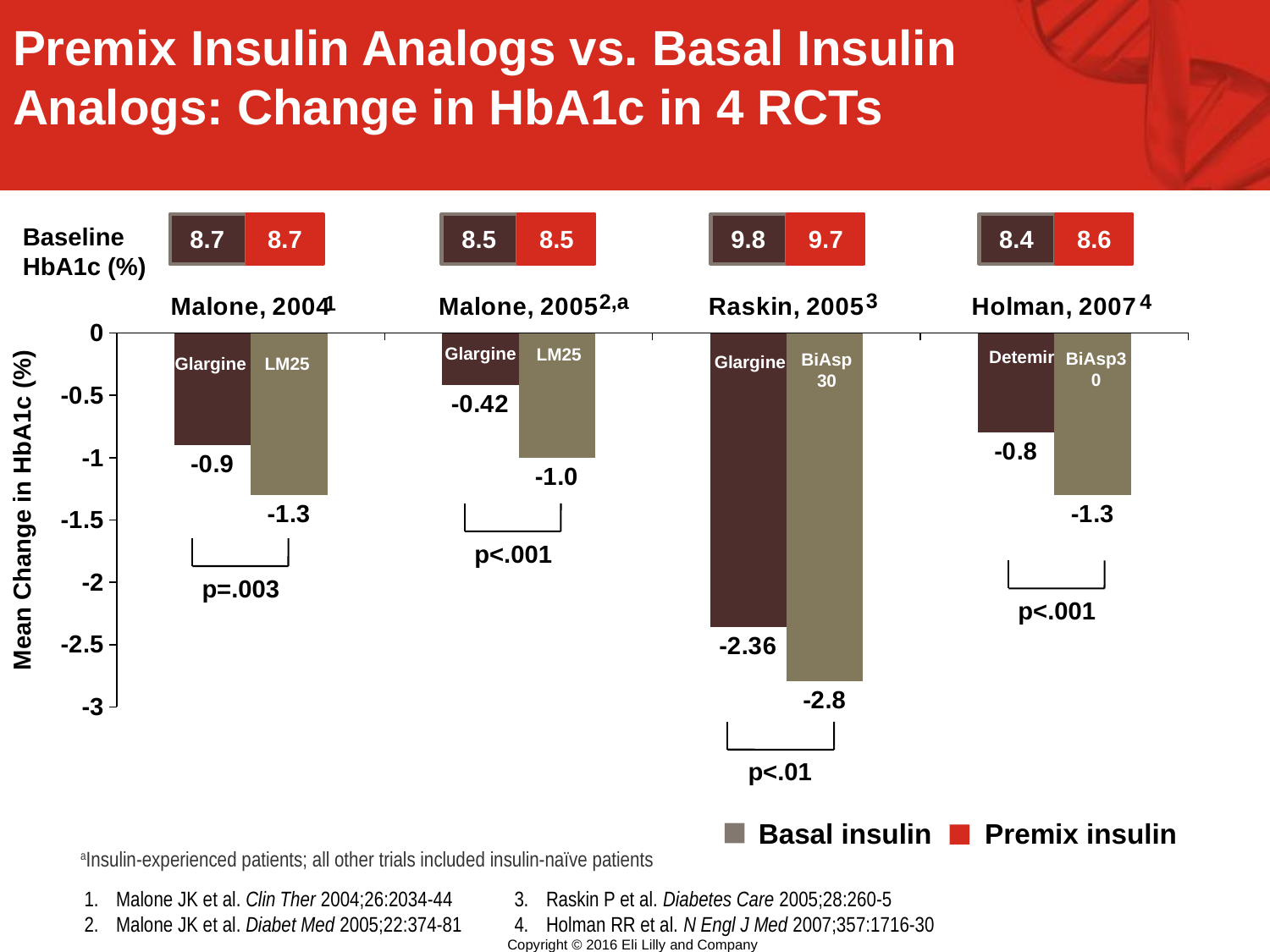
What type of chart is used to show the mean change in HbA1c? Bar chart How many studies (category groups) are plotted on the chart? 4 In the Holman, 2007 study, which arm had the larger reduction in HbA1c, detemir or BiAsp 30? BiAsp 30 What is the mean change in HbA1c for BiAsp 30 in the Raskin, 2005 study? -2.8 What is the mean change in HbA1c for detemir in the Holman, 2007 study? -0.8 How many series does the legend list? 2 Which study shows the smallest reduction in HbA1c for the basal insulin arm? Malone, 2005 What is the mean change in HbA1c for LM25 in the Malone, 2005 study? -1.0 What is the mean change in HbA1c for glargine in the Malone, 2004 study? -0.9 Which study shows the largest reduction in HbA1c for the premix insulin arm? Raskin, 2005 What is the difference between the glargine and BiAsp 30 mean changes in HbA1c in the Raskin, 2005 study? 0.44 What p-value is shown for the comparison in the Malone, 2004 study? p=.003